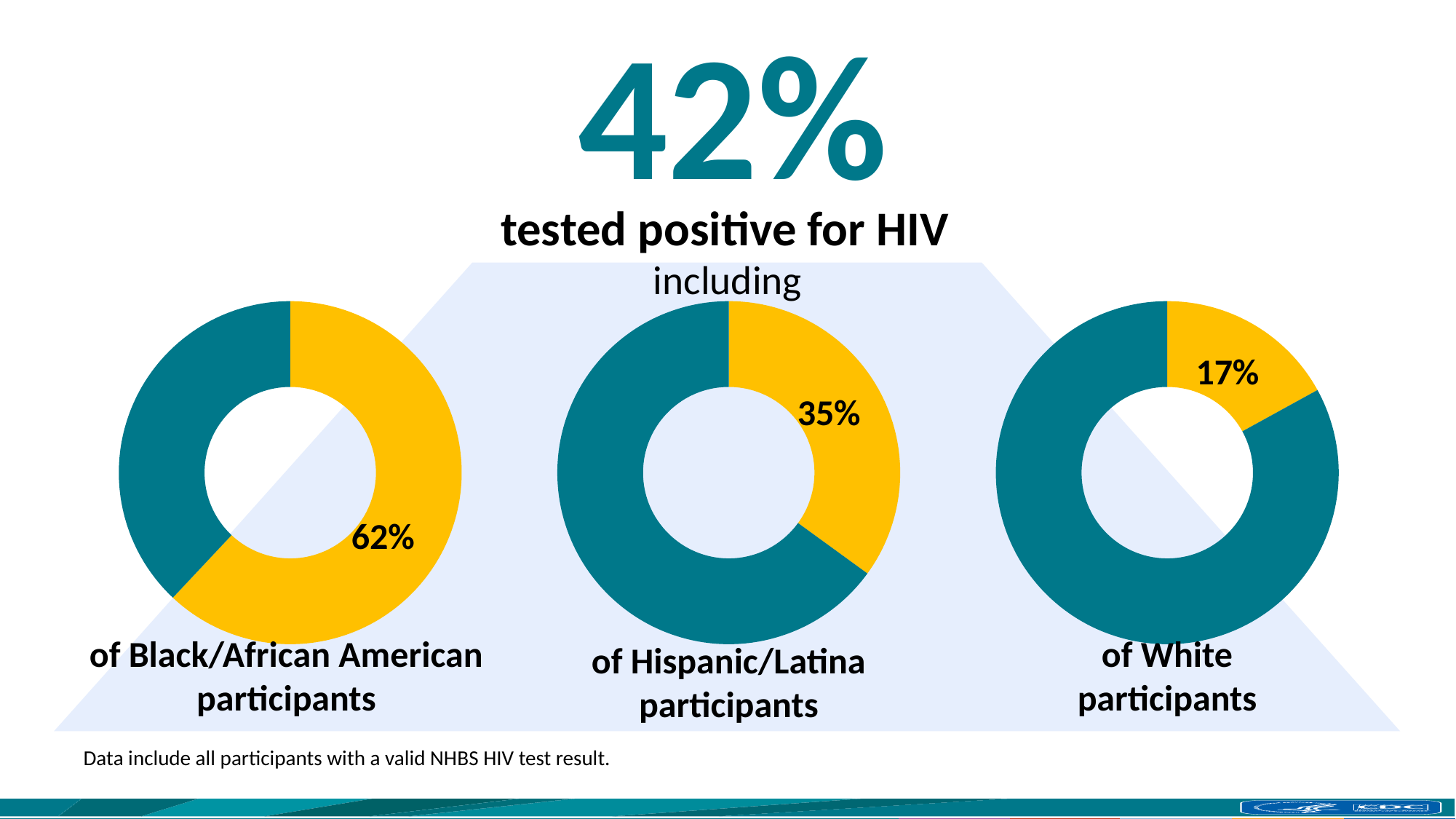
In the middle donut chart, what percentage of Hispanic/Latina participants tested positive for HIV? 35% What overall percentage of participants tested positive for HIV, according to the large number at the top of the slide? 42% How many donut charts are shown on the slide? 3 Across the three donut charts, which participant group has the lowest percentage testing positive for HIV? White participants Which is larger: the percentage for Hispanic/Latina participants or the percentage for White participants? Hispanic/Latina participants What is the difference in percentage points between the Hispanic/Latina chart (35%) and the White chart (17%)? 18 percentage points In the right donut chart, what percentage of White participants tested positive for HIV? 17% In the left donut chart, what percentage of Black/African American participants tested positive for HIV? 62% What is the difference in percentage points between the Black/African American chart (62%) and the Hispanic/Latina chart (35%)? 27 percentage points In the left donut chart, is the yellow slice for Black/African American participants greater or less than 50%? greater What kind of chart is used to show the percentage for each participant group? Donut (pie) chart Across the three donut charts, which participant group has the highest percentage testing positive for HIV? Black/African American participants